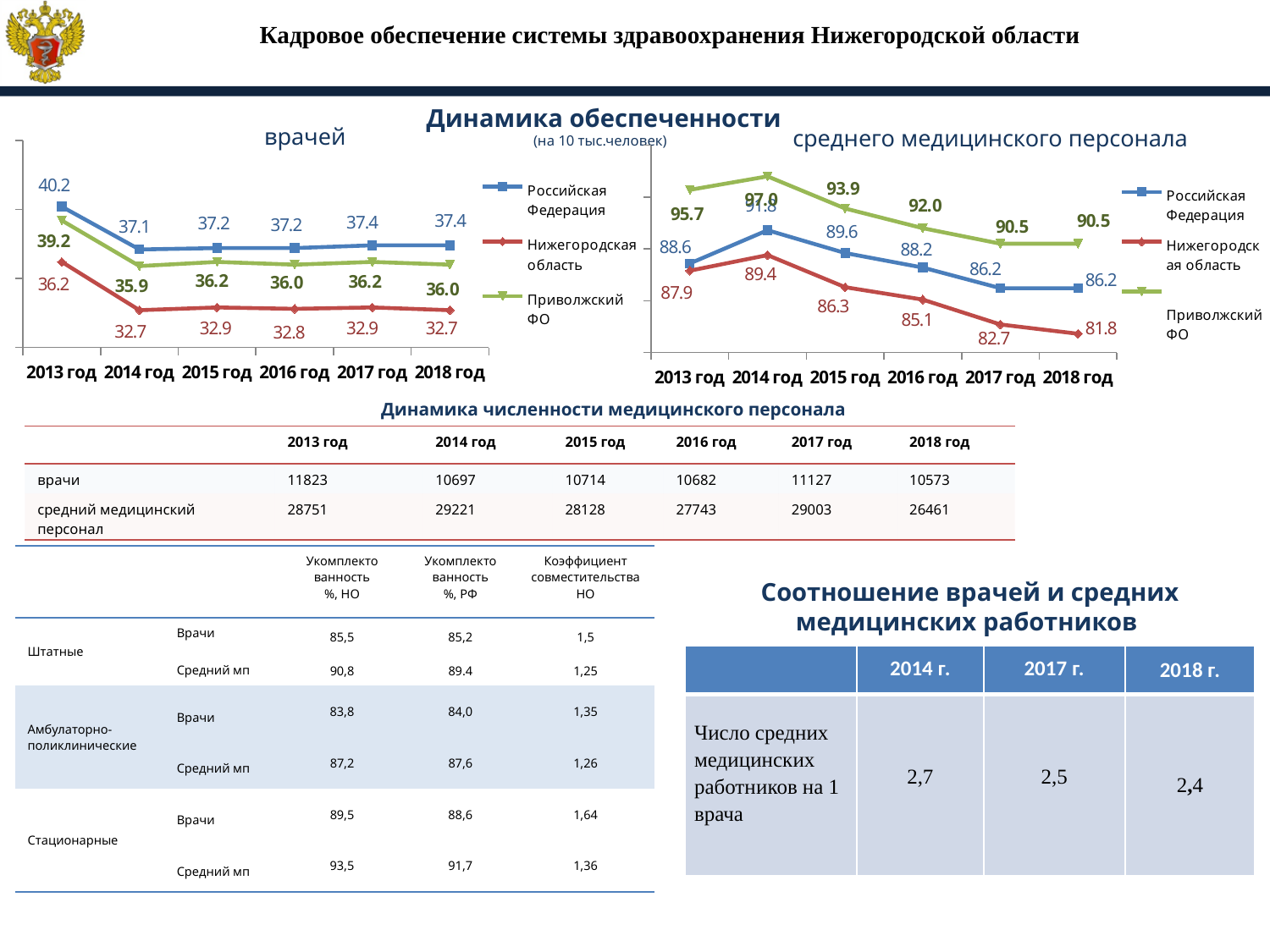
In the right chart (среднего медицинского персонала), which series has the highest value in 2016 год? Приволжский ФО In the left chart (врачей), what is the value for Приволжский ФО in 2015 год? 36.2 In the right chart (среднего медицинского персонала), what is the value for Нижегородская область in 2018 год? 81.8 How many series does the legend of the left chart (врачей) list? 3 In the right chart (среднего медицинского персонала), does the value for Нижегородская область rise or fall from 2014 год to 2018 год? fall In the left chart (врачей), what is the difference between Российская Федерация and Нижегородская область in 2018 год? 4.7 In the right chart (среднего медицинского персонала), what is the value for Российская Федерация in 2017 год? 86.2 In the right chart (среднего медицинского персонала), what is the value for Приволжский ФО in 2015 год? 93.9 In the left chart (врачей), which series has the lowest value in 2018 год? Нижегородская область In the left chart (врачей), what is the value for Нижегородская область in 2018 год? 32.7 What kind of chart is the right chart (среднего медицинского персонала)? line chart In the left chart (врачей), what is the value for Российская Федерация in 2013 год? 40.2